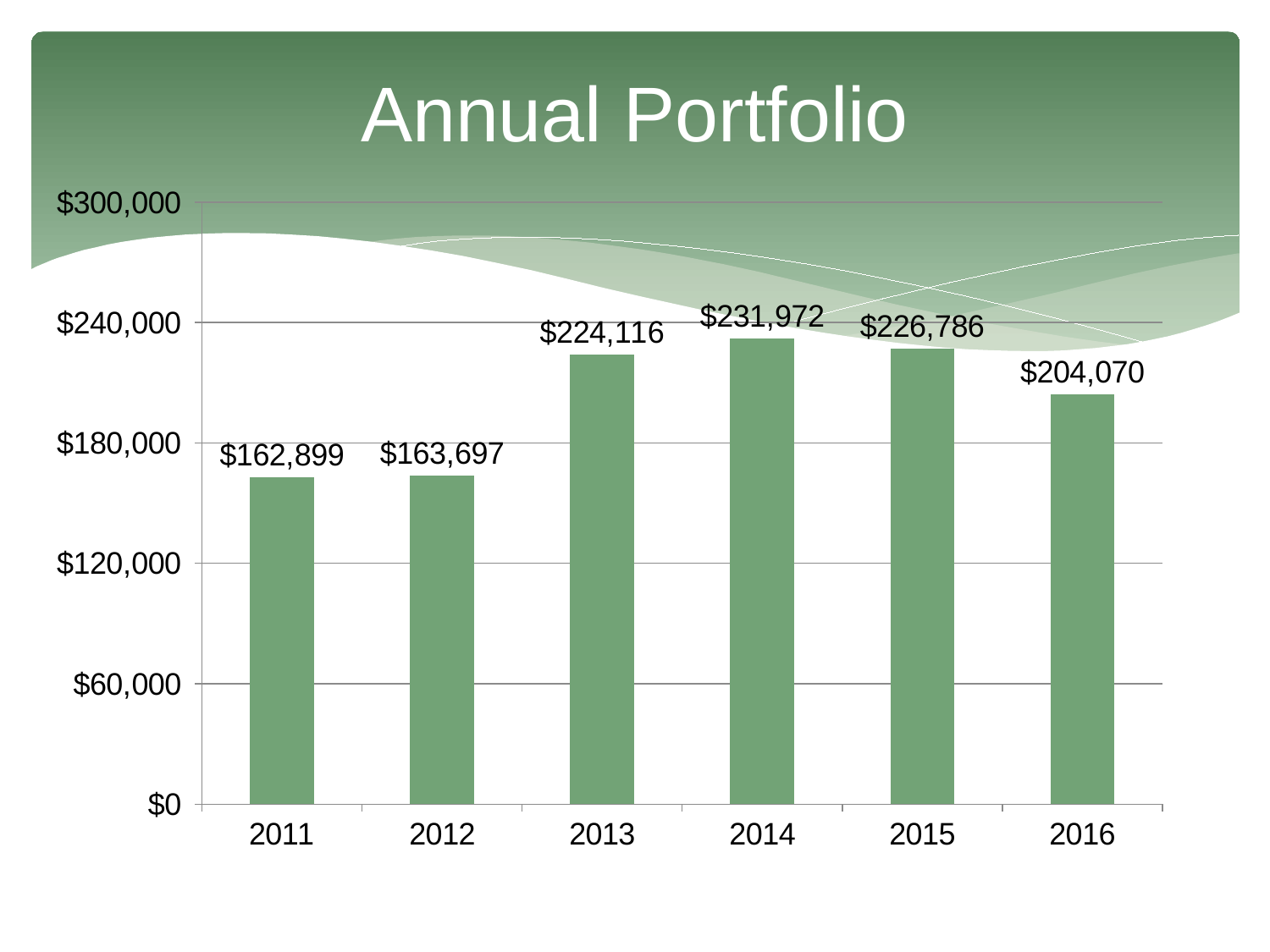
Which year has the lowest value? 2011 What is the value for 2011? $162,899 Which is larger, the value for 2013 or the value for 2015? 2015 What kind of chart is shown on the slide? bar chart What is the difference between the values for 2014 and 2011? $69,073 What is the difference between the values for 2015 and 2016? $22,716 What is the value for 2013? $224,116 Do the values rise or fall from 2014 to 2016? fall How many years are shown on the x axis? 6 Which year has the highest value? 2014 What is the value for 2016? $204,070 Is the value for 2016 greater or less than $240,000? less